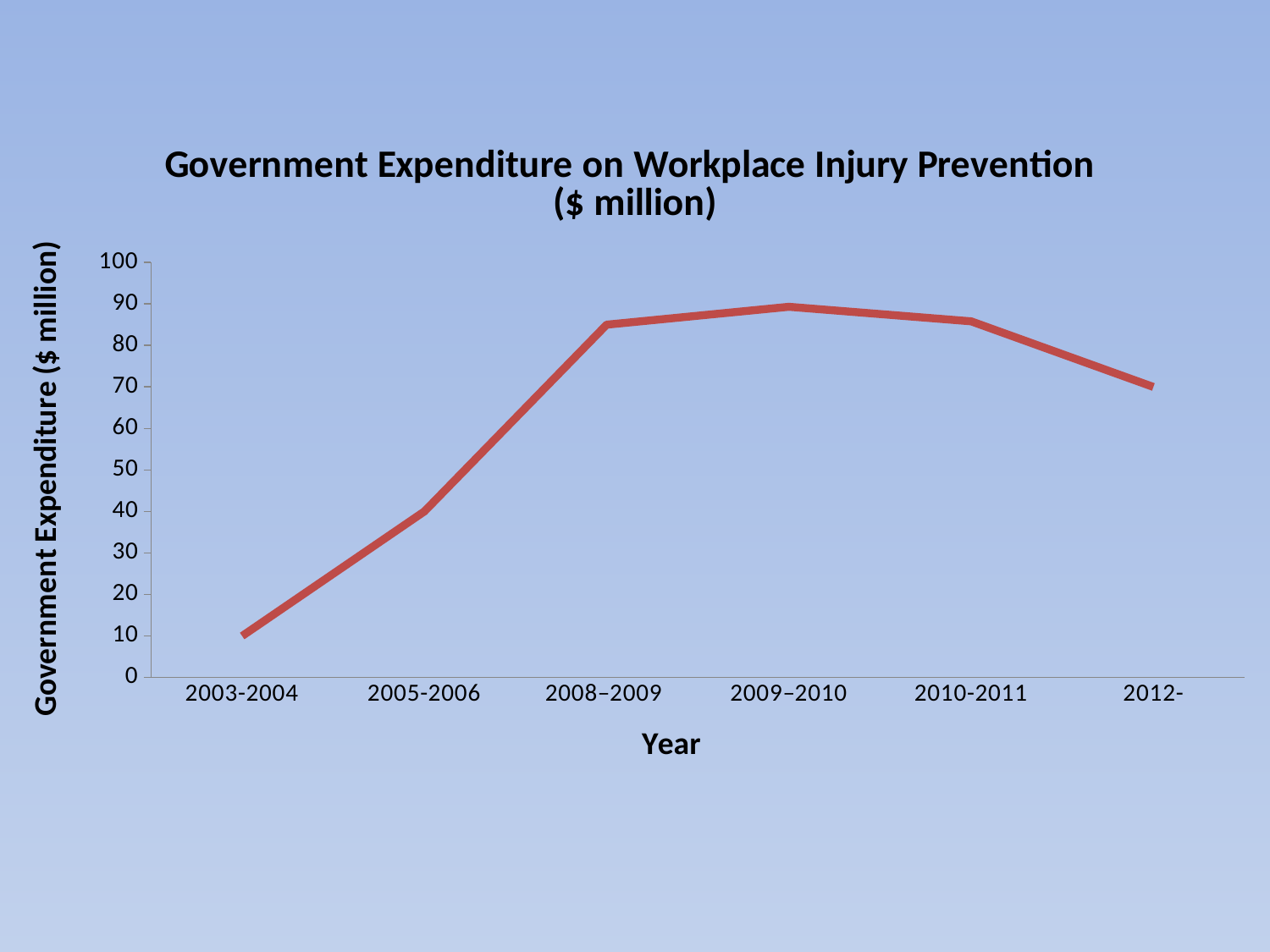
Which is larger, the expenditure for 2005-2006 or for 2012-? 2012- Which year has the lowest government expenditure? 2003-2004 Which year has the highest government expenditure? 2009–2010 What is the government expenditure for 2012-? 70 How does the expenditure change from 2003-2004 to 2009–2010? it rises Is the value for 2008–2009 greater or less than 80? greater What is the label on the vertical axis? Government Expenditure ($ million) How many data points are plotted on the line? 6 Is the value for 2010-2011 greater or less than 80? greater What kind of chart is shown on the slide? line chart What is the government expenditure for 2003-2004? 10 Is the value for 2005-2006 greater or less than 50? less